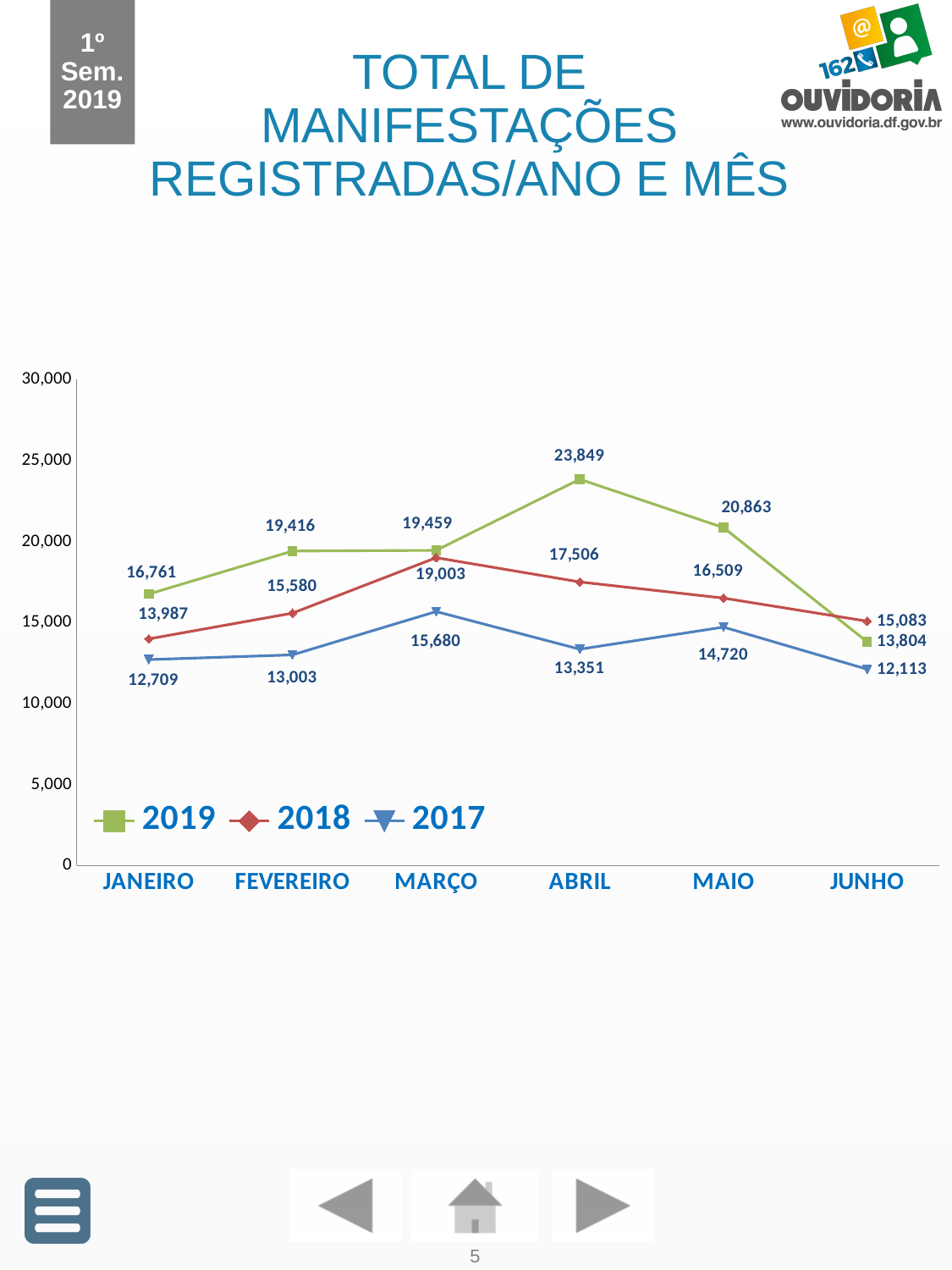
In which month does the 2017 series have its lowest value? JUNHO In which month does the 2019 series reach its highest value? ABRIL What kind of chart is shown on the slide? line chart Which is larger in JUNHO, the 2018 value or the 2019 value? 2018 What is the value for 2019 in ABRIL? 23,849 How many series does the legend list? 3 Does the 2019 series rise or fall from MAIO to JUNHO? fall How many months are shown on the x axis? 6 What is the value for 2018 in MARÇO? 19,003 What is the difference between the 2019 and 2018 values in MAIO? 4,354 Is the value for 2019 in ABRIL greater or less than 20,000? greater What is the value for 2017 in JUNHO? 12,113